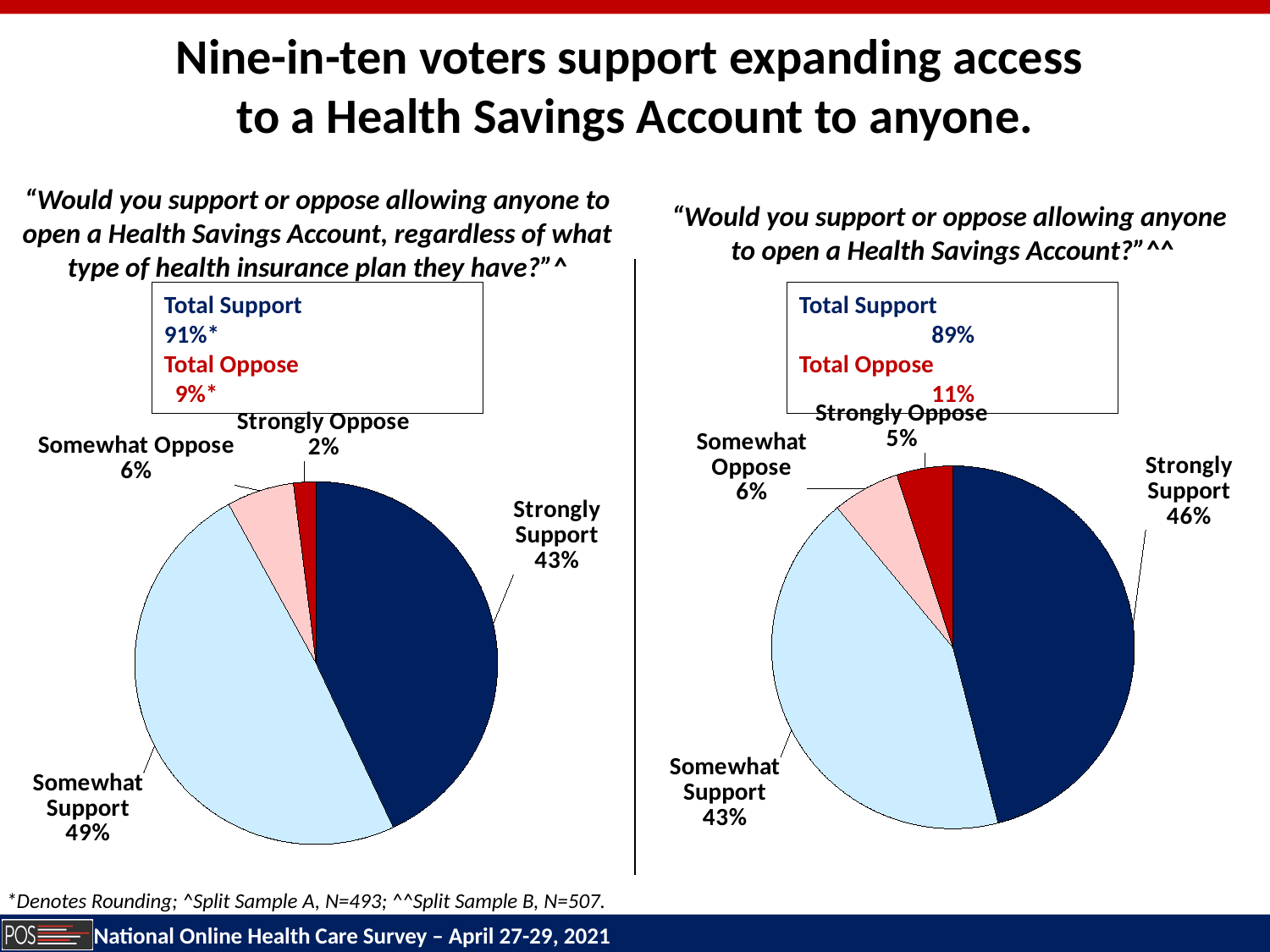
In the left pie chart, what is the difference between the Somewhat Oppose and Strongly Oppose shares? 4% In the left pie chart, which response category has the largest share? Somewhat Support Is the Strongly Oppose share larger in the left pie chart or the right pie chart? Right pie chart What is the Total Oppose figure shown for the left pie chart? 9%* In the right pie chart, which response category has the largest share? Strongly Support In the left pie chart, which response category has the smallest share? Strongly Oppose In the right pie chart, what is the difference between the Strongly Support and Somewhat Support shares? 3% In the left pie chart, what percentage of voters Strongly Support allowing anyone to open a Health Savings Account regardless of their health insurance plan? 43% In the right pie chart, what percentage of voters Somewhat Support allowing anyone to open a Health Savings Account? 43% How many response categories are shown in the right pie chart? 4 What is the Total Support figure shown for the right pie chart? 89% What type of chart is used on the left side of the slide? Pie chart